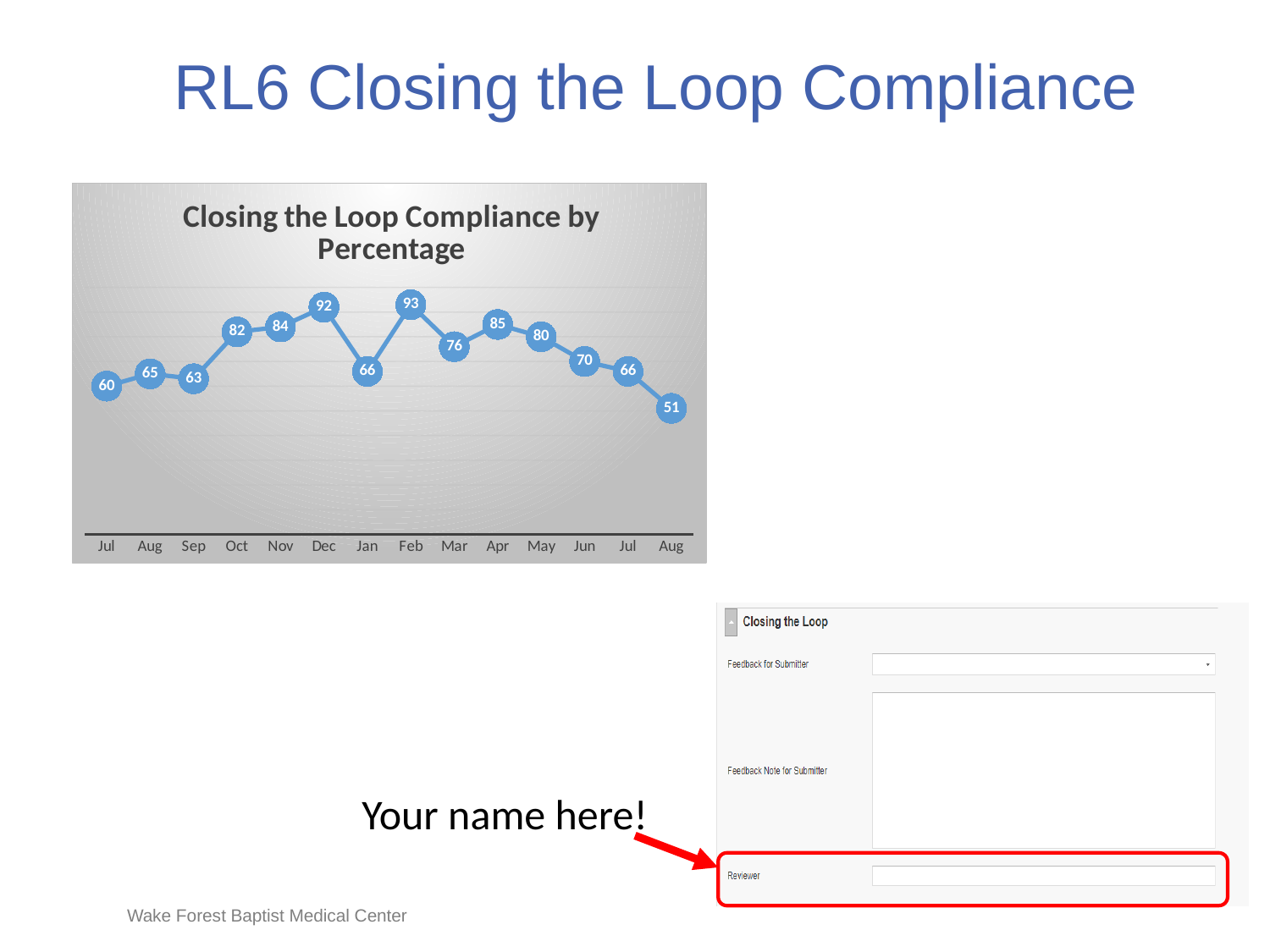
Do the values rise or fall from Mar to the final Aug? Fall Which month has the lowest value in the chart? Aug (the final point) What is the value for Oct in the chart? 82 What is the value for the last Aug (the final point) in the chart? 51 What is the value for Dec in the chart? 92 What is the value for Feb in the chart? 93 What is the title of the chart? Closing the Loop Compliance by Percentage Which is larger, the value for Apr or the value for May? Apr How many data points are plotted in the chart? 14 What type of chart is shown on the slide? Line chart Which month has the highest value in the chart? Feb What is the difference between the values for Feb and Jan? 27